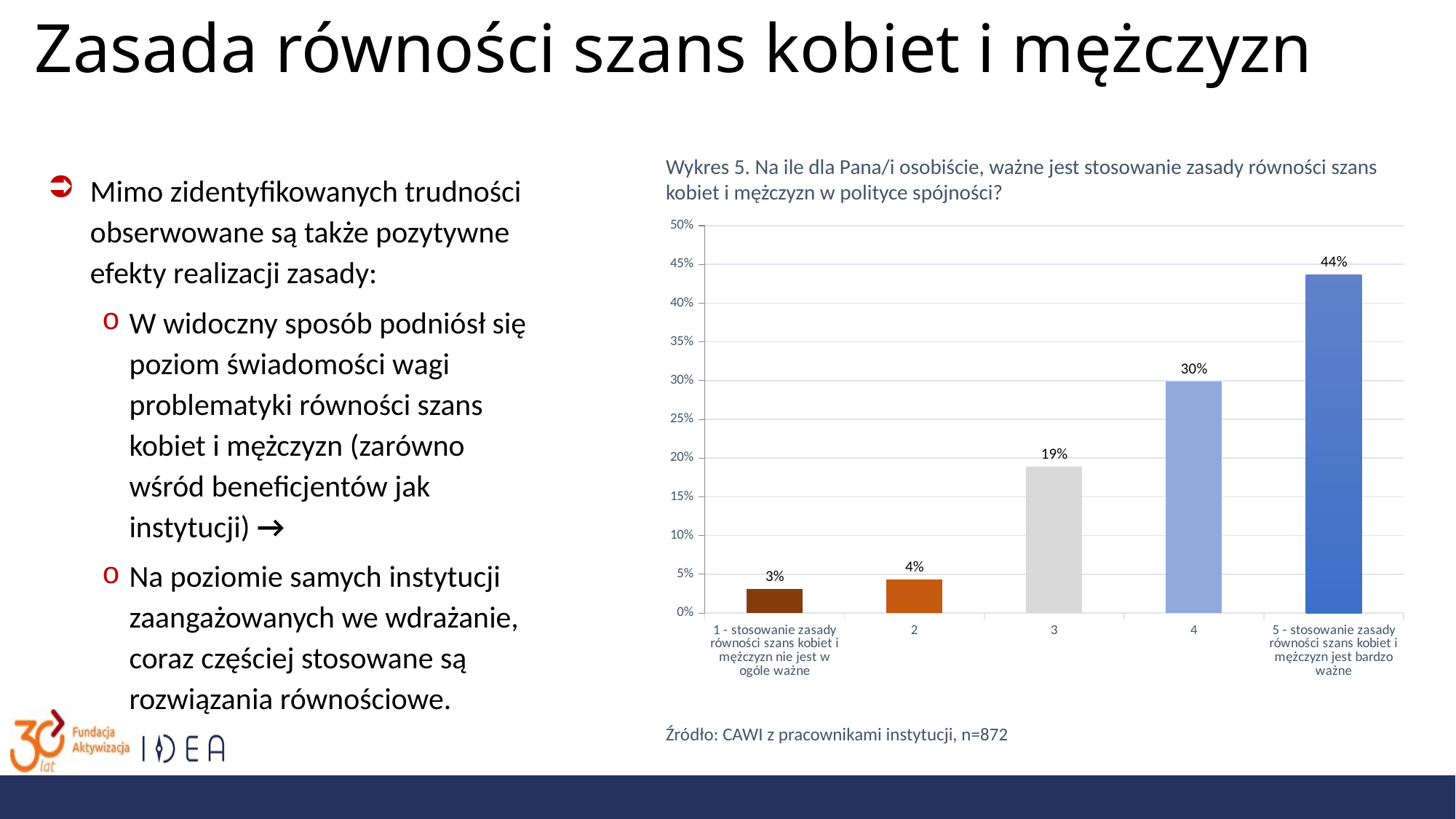
What percentage is shown for category 5 (stosowanie zasady równości szans kobiet i mężczyzn jest bardzo ważne)? 44% What is the value shown for rating 4? 30% Do the values rise or fall from rating 1 to rating 5 along the x axis? rise What percentage of respondents chose rating 3 on the chart? 19% How many categories are shown on the x axis of the chart? 5 What is the value for category 1 (stosowanie zasady równości szans kobiet i mężczyzn nie jest w ogóle ważne)? 3% Which is larger, the value for rating 2 or the value for rating 3? rating 3 Which rating category has the lowest value? 1 - stosowanie zasady równości szans kobiet i mężczyzn nie jest w ogóle ważne What is the difference between the values for rating 5 and rating 4? 14% What is the difference between the values for rating 3 and rating 2? 15% What kind of chart is shown on the slide? bar chart Which rating category has the highest value? 5 - stosowanie zasady równości szans kobiet i mężczyzn jest bardzo ważne